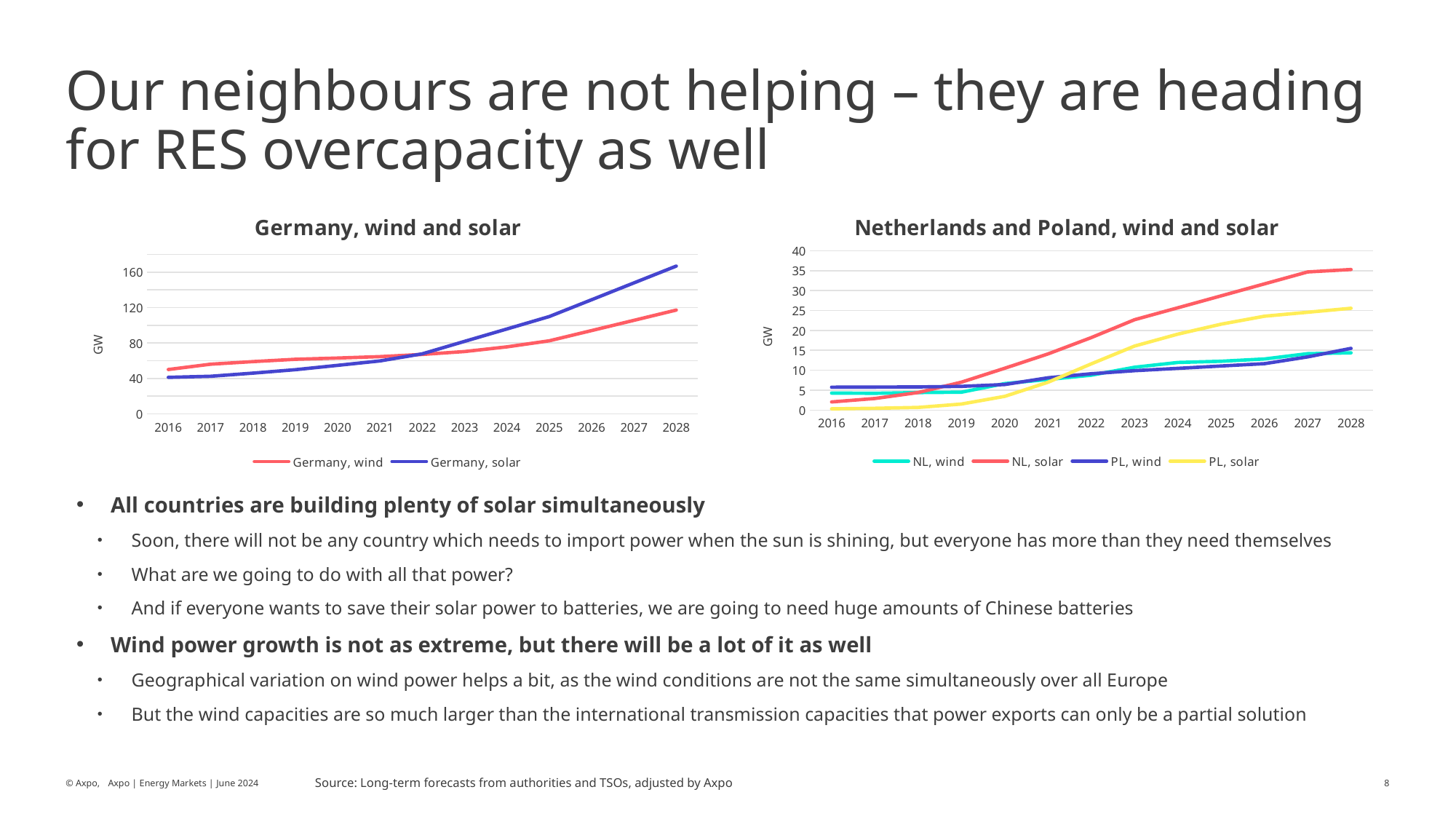
In the "Germany, wind and solar" chart, does the Germany, solar series rise or fall from 2016 to 2028? rise What kind of chart is the "Germany, wind and solar" chart? line chart In the "Germany, wind and solar" chart, is the value for Germany, solar in 2028 greater or less than 160? greater In the "Germany, wind and solar" chart, which series is higher in 2028, Germany, wind or Germany, solar? Germany, solar In the "Germany, wind and solar" chart, is the value for Germany, wind in 2016 greater or less than 40? greater How many series does the legend of the "Germany, wind and solar" chart list? 2 In the "Germany, wind and solar" chart, which series is higher in 2016, Germany, wind or Germany, solar? Germany, wind In the "Netherlands and Poland, wind and solar" chart, is the value for NL, solar in 2028 greater or less than 30? greater In the "Netherlands and Poland, wind and solar" chart, which series has the lowest value in 2016? PL, solar How many series does the legend of the "Netherlands and Poland, wind and solar" chart list? 4 How many years are shown on the x axis of the "Germany, wind and solar" chart? 13 In the "Netherlands and Poland, wind and solar" chart, which series has the highest value in 2028? NL, solar